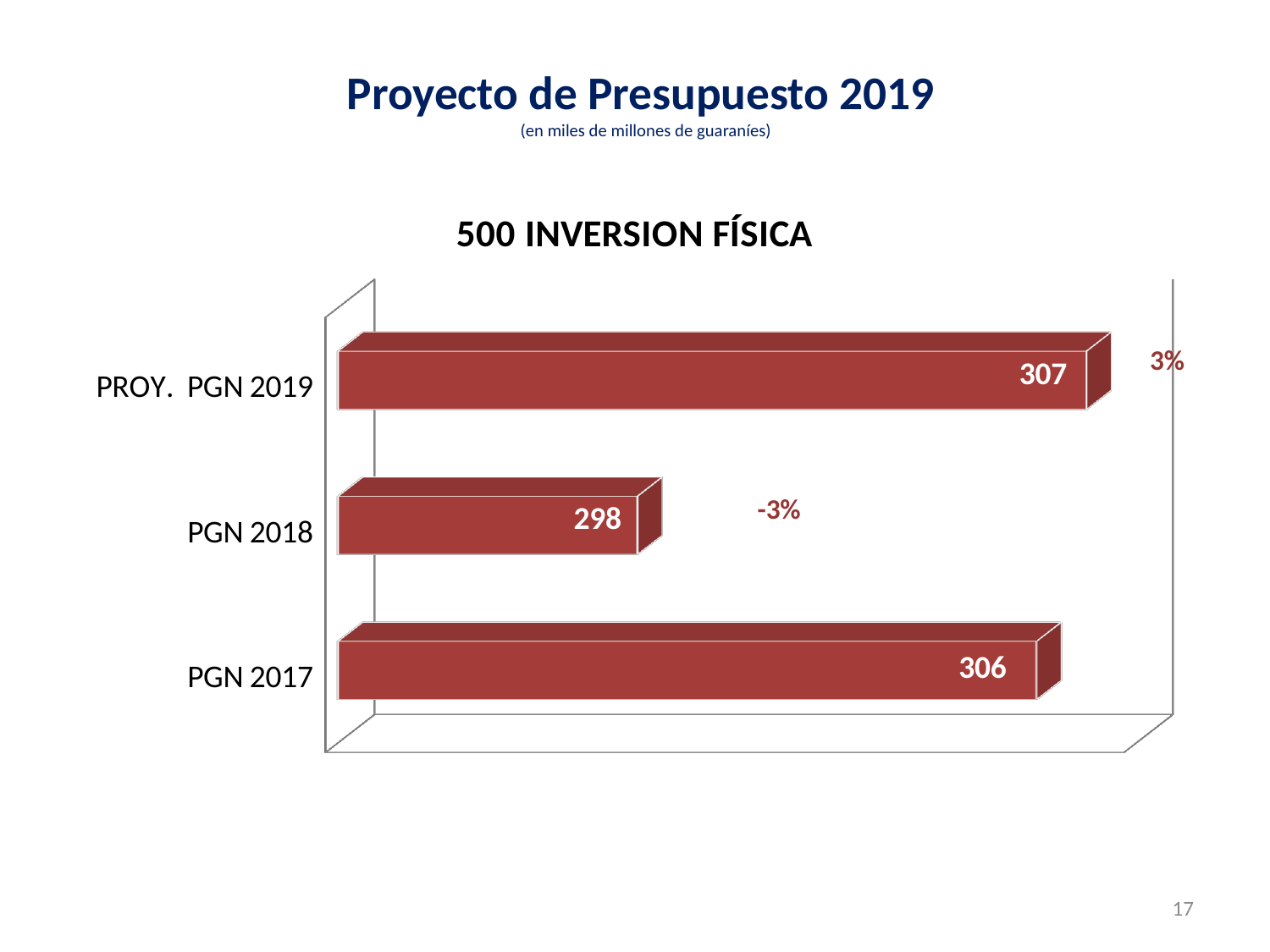
What is the value for PGN 2018? 298 What is the value for PROY. PGN 2019? 307 How many categories are shown in the chart? 3 Which category has the highest value according to the data labels? PROY. PGN 2019 Which category has the lowest value? PGN 2018 Which is larger, the value for PGN 2017 or the value for PGN 2018? PGN 2017 What is the difference between the values for PROY. PGN 2019 and PGN 2018? 9 What is the difference between the values for PGN 2017 and PGN 2018? 8 What percentage change is shown next to the PGN 2018 bar? -3% What kind of chart is shown on the slide? Bar chart What is the title of the chart? 500 INVERSION FÍSICA What is the value for PGN 2017? 306